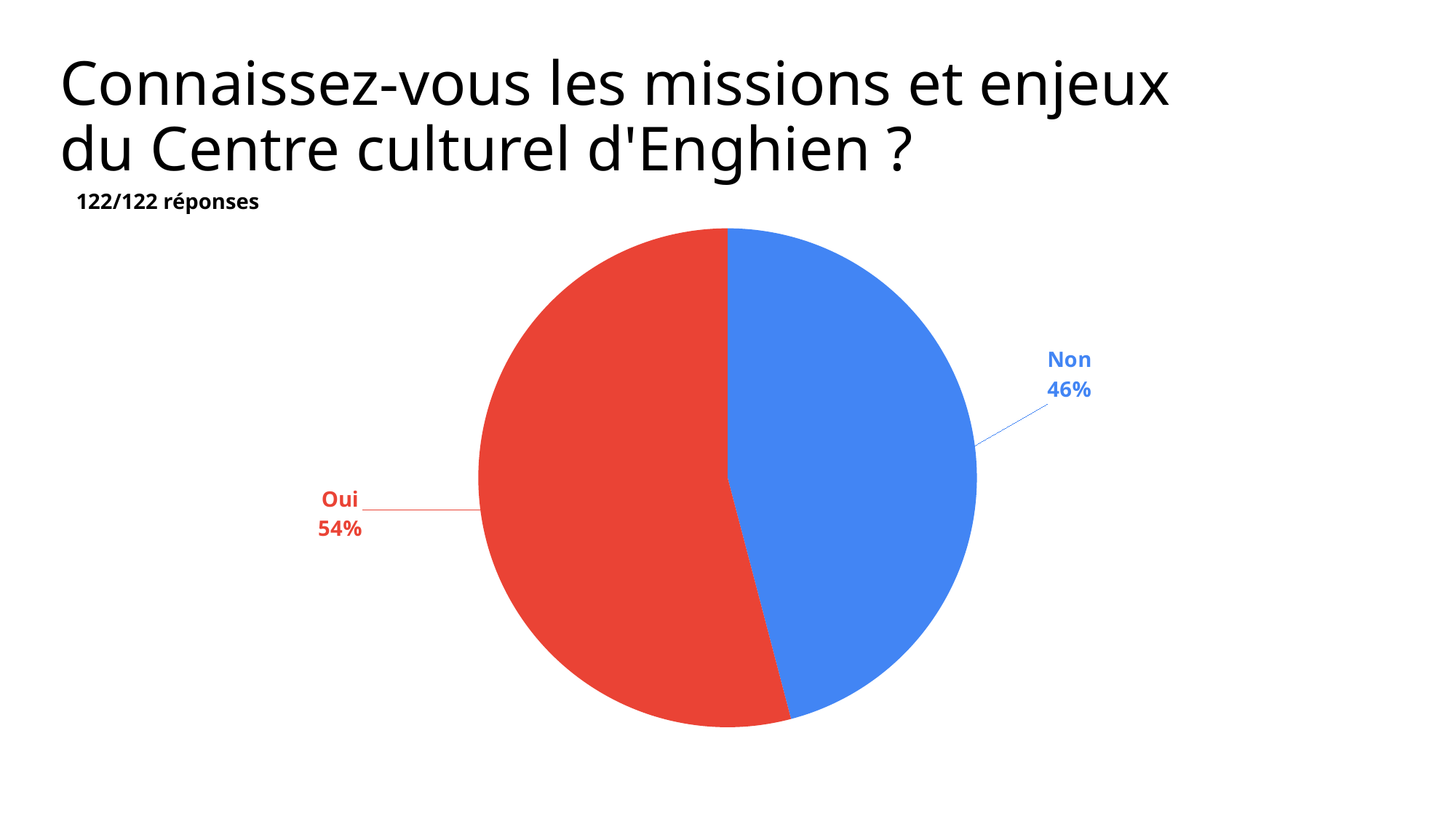
Which is larger, the "Oui" slice or the "Non" slice? Oui What is the difference in percentage points between the "Oui" and "Non" slices? 8 What kind of chart is shown on the slide? Pie chart What colour is the "Non" slice of the pie chart? Blue How many slices does the pie chart have? 2 Which slice is the largest in the pie chart? Oui What share of the pie does the "Oui" slice represent? 54% How many responses does the slide say were collected? 122/122 réponses What share of the pie does the "Non" slice represent? 46% Which slice is the smallest in the pie chart? Non